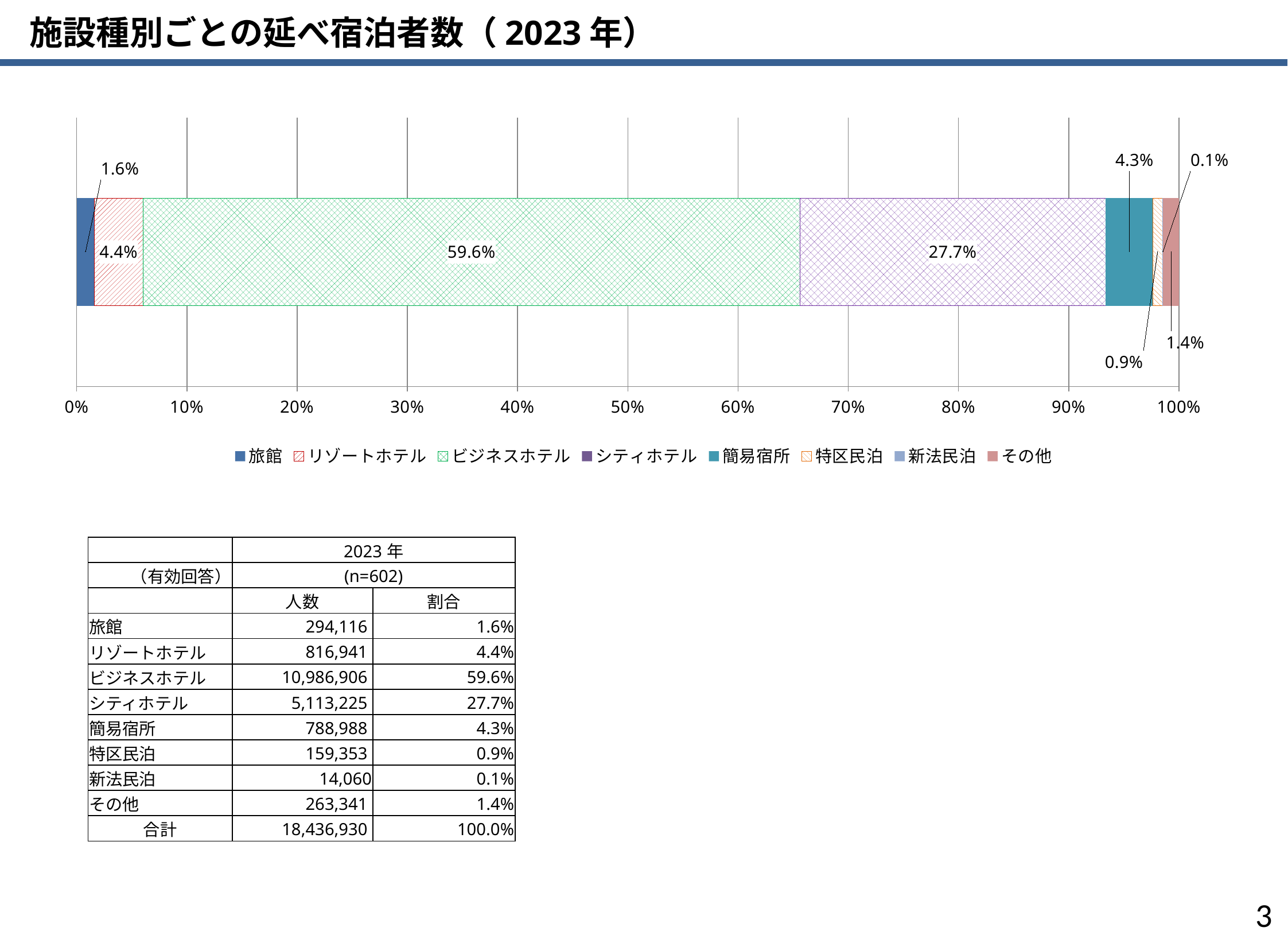
Which has a larger share, リゾートホテル or 簡易宿所? リゾートホテル What percentage does the chart show for シティホテル? 27.7% What percentage does the chart show for 旅館? 1.6% What is the title of the slide containing the chart? 施設種別ごとの延べ宿泊者数（2023年） What is the difference in percentage points between ビジネスホテル and シティホテル? 31.9 How many series does the legend list? 8 Which facility type has the largest share in the chart? ビジネスホテル What kind of chart is shown on the slide? Stacked bar chart What percentage does the chart show for ビジネスホテル? 59.6% What is the combined share of 特区民泊 and 新法民泊 in the chart? 1.0% What percentage does the chart show for 簡易宿所? 4.3% Which facility type has the smallest share in the chart? 新法民泊